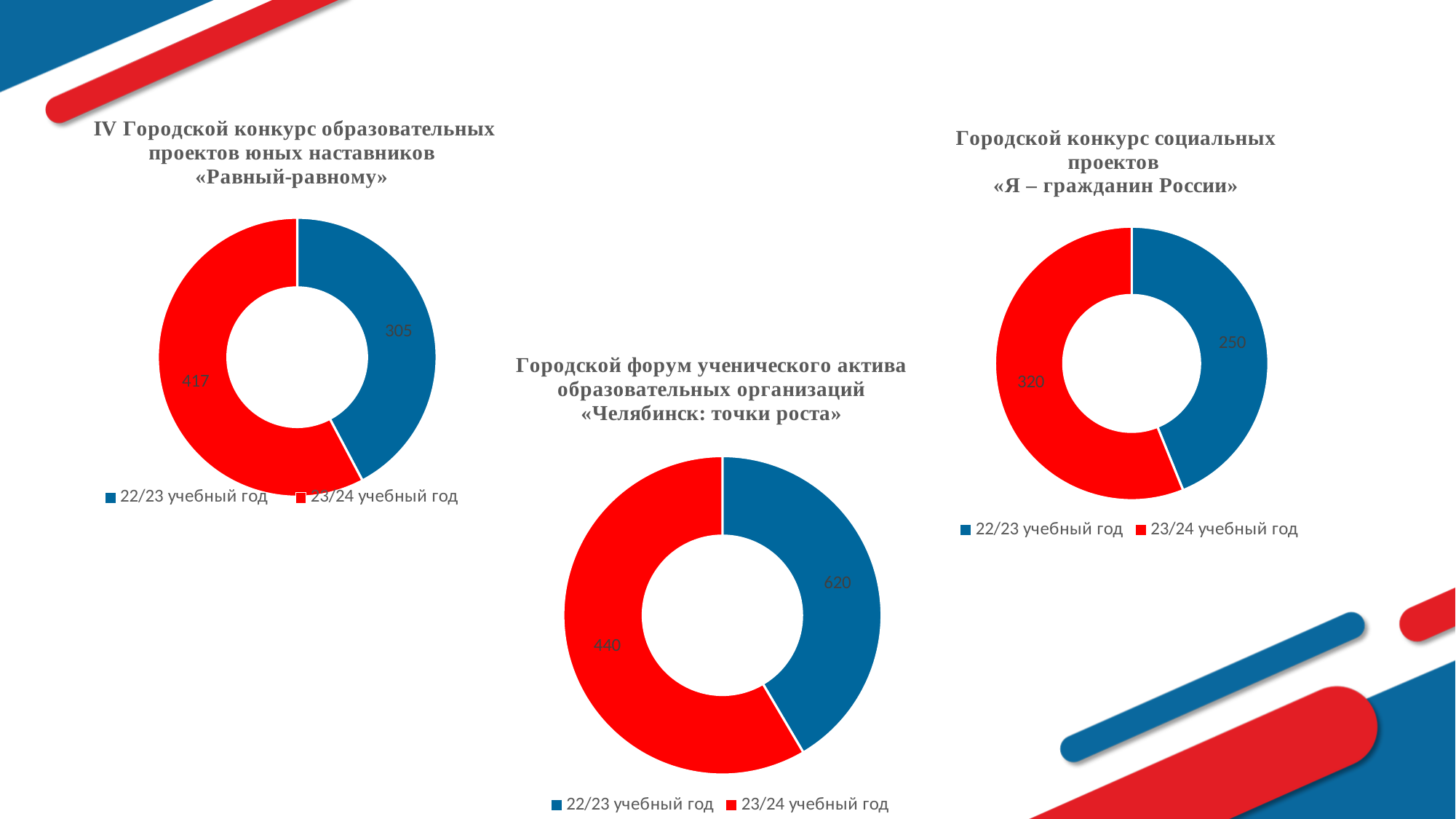
In the «Челябинск: точки роста» chart, what is the difference between the 22/23 and 23/24 values? 180 In the «Равный-равному» chart, what is the difference between the 23/24 and 22/23 values? 112 In the «Челябинск: точки роста» chart, what is the value for 22/23 учебный год? 620 In the «Равный-равному» chart, what is the value for 23/24 учебный год? 417 How many series does the legend of the «Равный-равному» chart list? 2 In the «Я – гражданин России» chart, what is the total of the two values? 570 What type of chart is used for «Челябинск: точки роста»? Doughnut (pie) chart In the «Я – гражданин России» chart, which year has the larger value? 23/24 учебный год In the «Я – гражданин России» chart, what is the value for 23/24 учебный год? 320 In the «Равный-равному» chart, what is the value for 22/23 учебный год? 305 In the «Челябинск: точки роста» chart, what is the value for 23/24 учебный год? 440